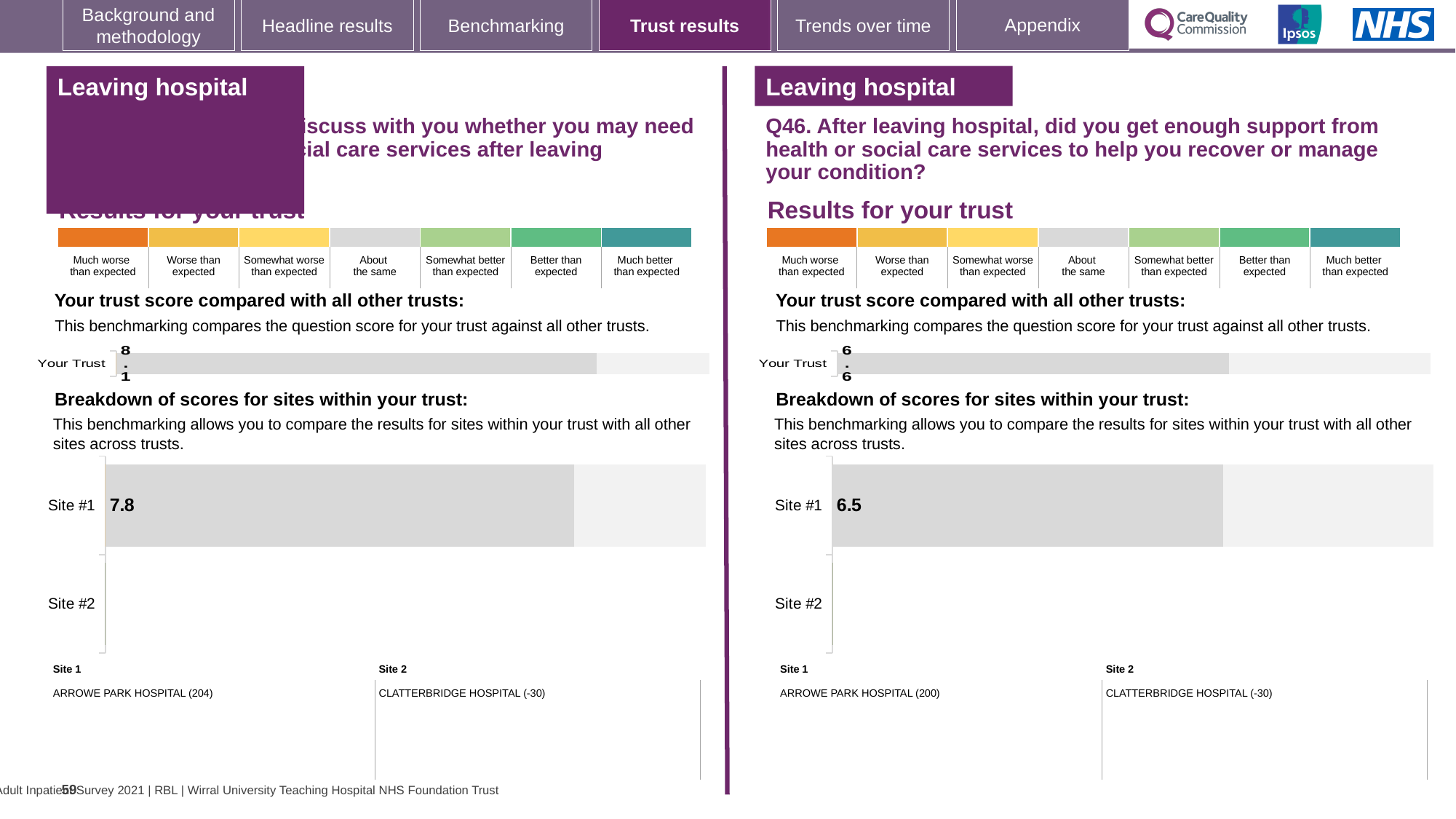
In the left breakdown chart, which site has the higher score, Site #1 or Site #2? Site #1 What is the difference between the Your Trust score on the left half (8.1) and the Your Trust score on the right half (6.6)? 1.5 On the right half of the slide (Q46), what is the score shown for Your Trust in the 'Your trust score compared with all other trusts' chart? 6.6 Which is larger: the Site #1 score in the left breakdown chart or the Site #1 score in the right breakdown chart? Left (7.8) Which hospital is listed as Site 1 on the right half of the slide? ARROWE PARK HOSPITAL (200) In the right 'Breakdown of scores for sites within your trust' chart (Q46), what is the score for Site #1? 6.5 How many categories are shown in the coloured benchmark scale above 'Your trust score compared with all other trusts' on the right half of the slide? 7 On the left half of the slide, what is the score shown for Your Trust in the 'Your trust score compared with all other trusts' chart? 8.1 In the left 'Breakdown of scores for sites within your trust' chart, what is the score for Site #1? 7.8 What type of chart is used to show the Site #1 and Site #2 scores on the slide? Bar chart What is the difference between the Site #1 score in the left breakdown chart and the Site #1 score in the right breakdown chart? 1.3 How many sites are listed in the left 'Breakdown of scores for sites within your trust' chart? 2